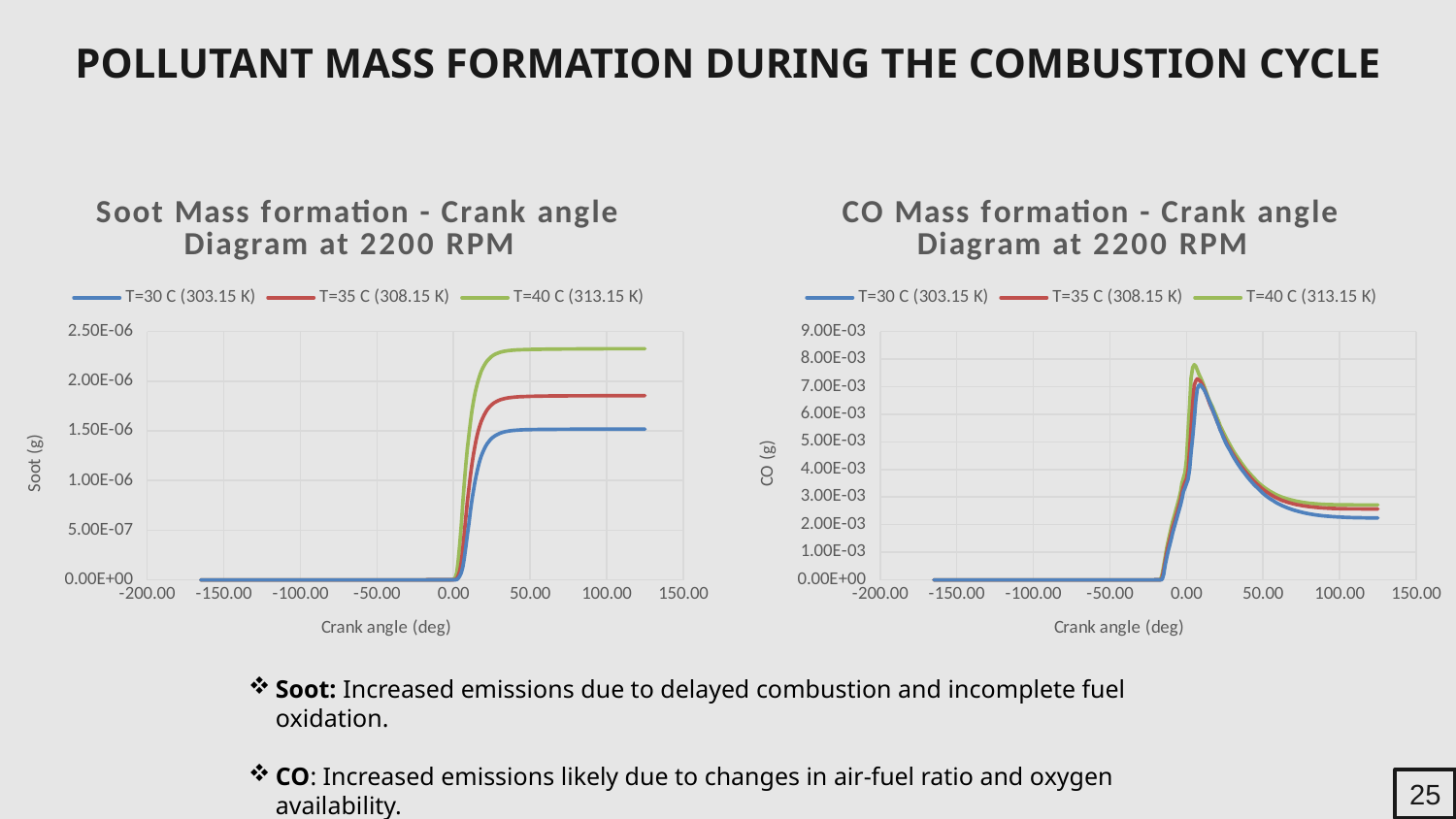
In the 'CO Mass formation' chart, which series reaches the highest peak CO value? T=40 C (313.15 K) In the 'Soot Mass formation' chart, which series reaches the highest soot mass at the end of the crank angle range? T=40 C (313.15 K) In the 'CO Mass formation' chart, is the peak CO value for T=40 C (313.15 K) greater or less than 7.00E-03? greater In the 'Soot Mass formation' chart, which series has the lowest soot mass at the end of the crank angle range? T=30 C (303.15 K) In the 'CO Mass formation' chart, is the CO value for T=30 C (303.15 K) at a crank angle of 100.00 greater or less than 3.00E-03? less In the 'CO Mass formation' chart, after reaching its peak near a crank angle of 0, does the CO value rise or fall as the crank angle increases? fall In the 'Soot Mass formation' chart, is the final soot value for T=40 C (313.15 K) greater or less than 2.00E-06? greater What kind of chart is the 'Soot Mass formation - Crank angle Diagram at 2200 RPM' chart? line chart What is the y-axis title of the 'CO Mass formation' chart? CO (g) What is the x-axis title of the 'Soot Mass formation' chart? Crank angle (deg) How many series does the legend of the 'CO Mass formation - Crank angle Diagram at 2200 RPM' chart list? 3